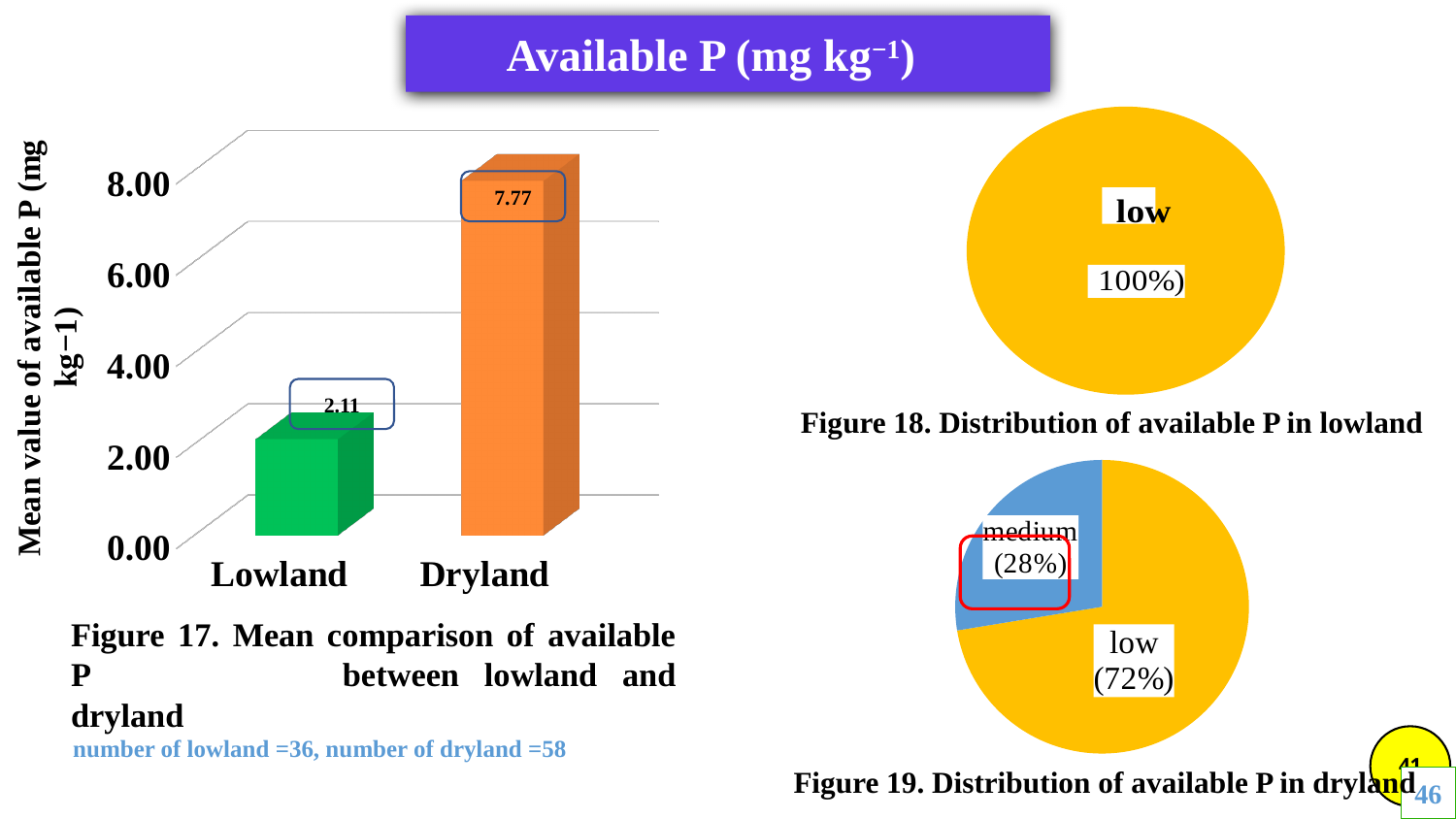
In Figure 17, which category has the lower mean value of available P? Lowland In Figure 19, which category has the larger share, low or medium? low What is the title of the chart in Figure 19? Distribution of available P in dryland In Figure 17, what is the mean value of available P for Dryland? 7.77 In Figure 17, how many categories are plotted? 2 In Figure 17, what is the difference between the Dryland and Lowland mean values of available P? 5.66 In Figure 17, is the value for Lowland greater or less than 4.00? less In Figure 19, what share of the pie does the 'medium' category have? 28% What kind of chart is Figure 17? Bar chart In Figure 17, what is the mean value of available P for Lowland? 2.11 In Figure 18, what share of the pie does the 'low' category have? 100% In Figure 17, which category has the higher mean value of available P? Dryland